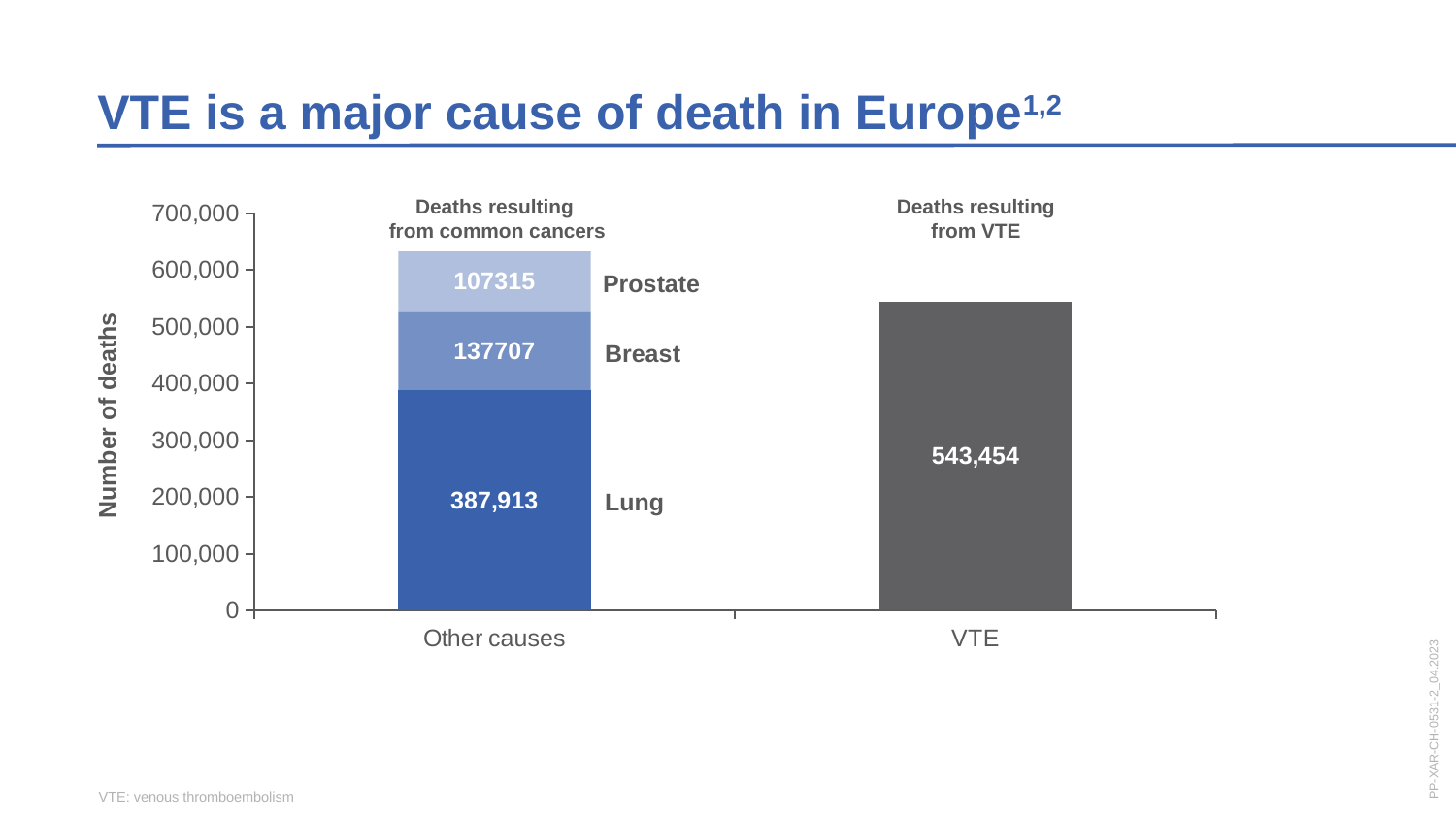
How many deaths resulting from VTE are shown on the chart? 543,454 Which cancer segment in the Other causes bar has the highest number of deaths? Lung What value is shown for prostate cancer deaths in the Other causes bar? 107315 By how much do deaths from VTE exceed deaths from lung cancer? 155,541 What is the label of the y axis? Number of deaths Which cancer segment in the Other causes bar has the lowest number of deaths? Prostate Which is larger: deaths from VTE or deaths from lung cancer? VTE What is the number of deaths from lung cancer shown in the stacked bar for Other causes? 387,913 How many categories are shown on the x axis of the chart? 2 What kind of chart is shown on the slide? Bar chart What value is shown for breast cancer deaths in the Other causes bar? 137707 What is the total of the stacked Other causes bar (lung, breast and prostate combined)? 632,935